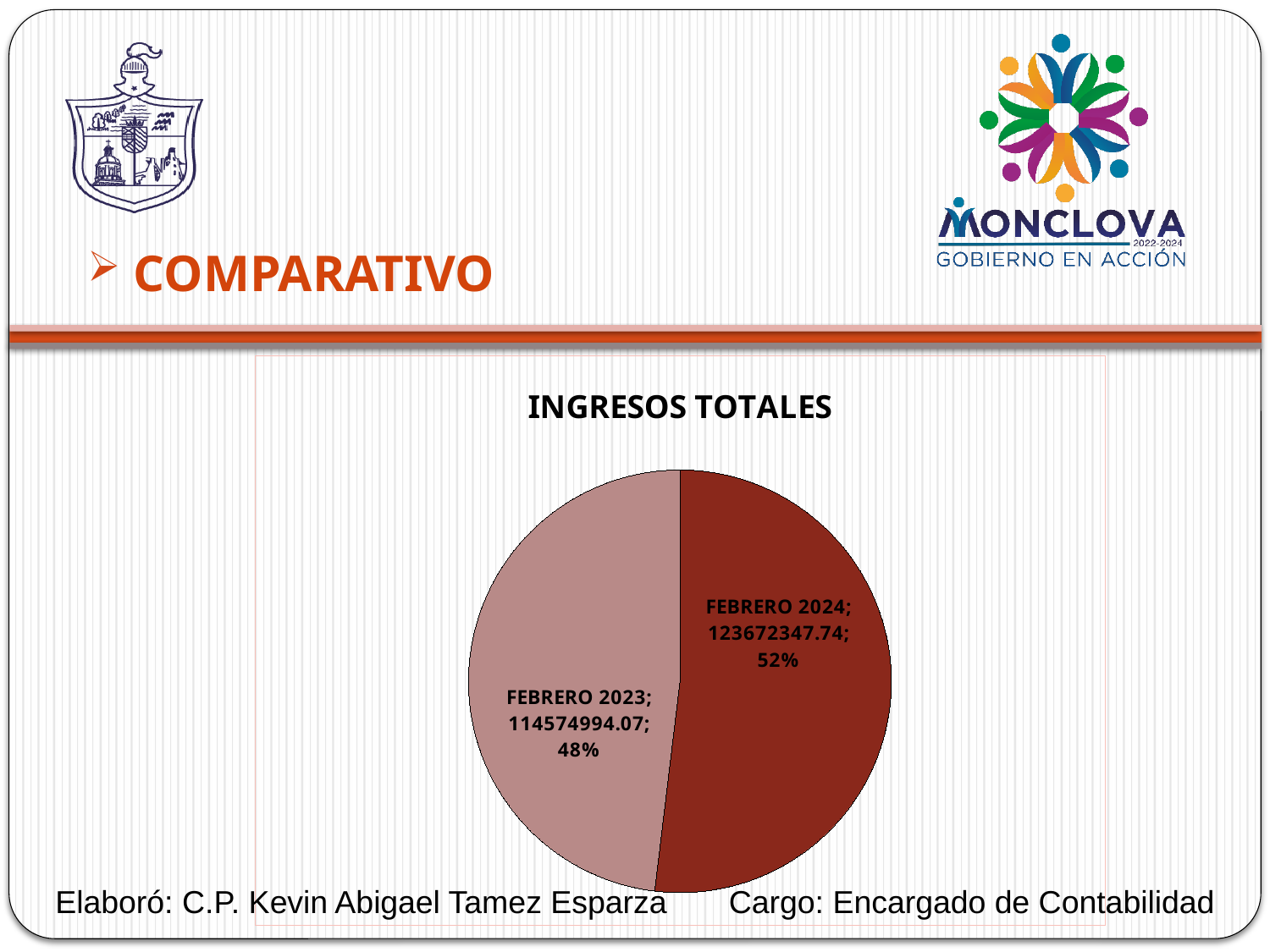
What kind of chart is shown on the slide? pie chart How many slices does the pie chart have? 2 Which slice of the pie chart is coloured dark red? FEBRERO 2024 What share of the pie does FEBRERO 2024 represent? 52% What is the value shown for FEBRERO 2023? 114574994.07 Which is larger, the value for FEBRERO 2024 or FEBRERO 2023? FEBRERO 2024 What is the title of the pie chart? INGRESOS TOTALES Which slice is the smallest in the pie chart? FEBRERO 2023 What is the value shown for FEBRERO 2024? 123672347.74 What is the difference between the values for FEBRERO 2024 and FEBRERO 2023? 9097353.67 Which slice is the largest in the pie chart? FEBRERO 2024 What share of the pie does FEBRERO 2023 represent? 48%